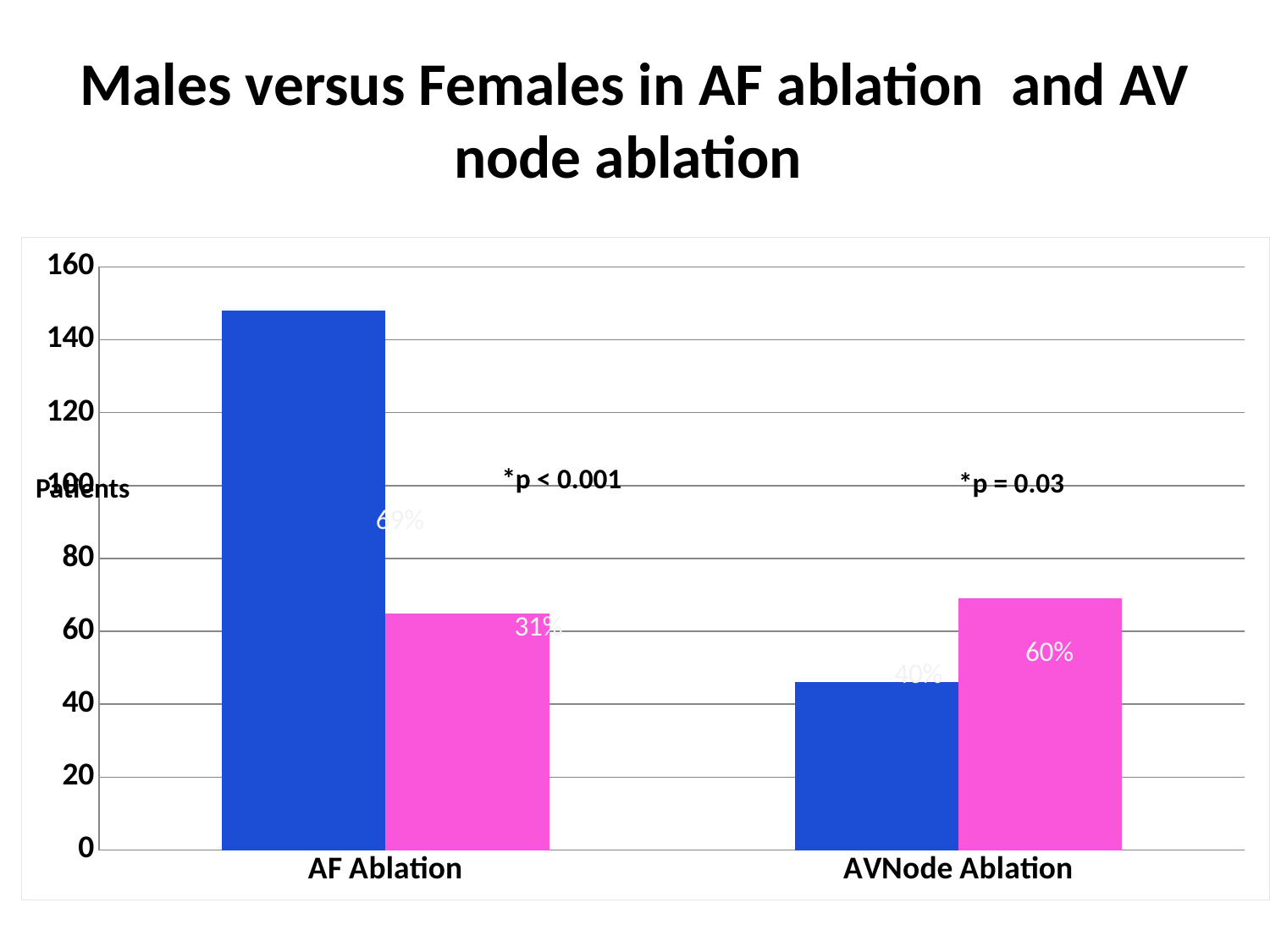
For AVNode Ablation, which bar is taller, the blue bar or the pink bar? the pink bar What percentage label is printed on the pink bar for AF Ablation? 31% How many categories are shown on the x axis? 2 Is the value of the pink bar for AF Ablation greater or less than 80? less What percentage label is printed on the blue bar for AF Ablation? 69% What is the label on the vertical axis of the chart? Patients Which bar is the tallest in the chart? the blue bar for AF Ablation What percentage label is printed on the pink bar for AVNode Ablation? 60% Is the value of the blue bar for AF Ablation greater or less than 140? greater Is the value of the blue bar for AVNode Ablation greater or less than 60? less What kind of chart is shown on the slide? bar chart What percentage label is printed on the blue bar for AVNode Ablation? 40%